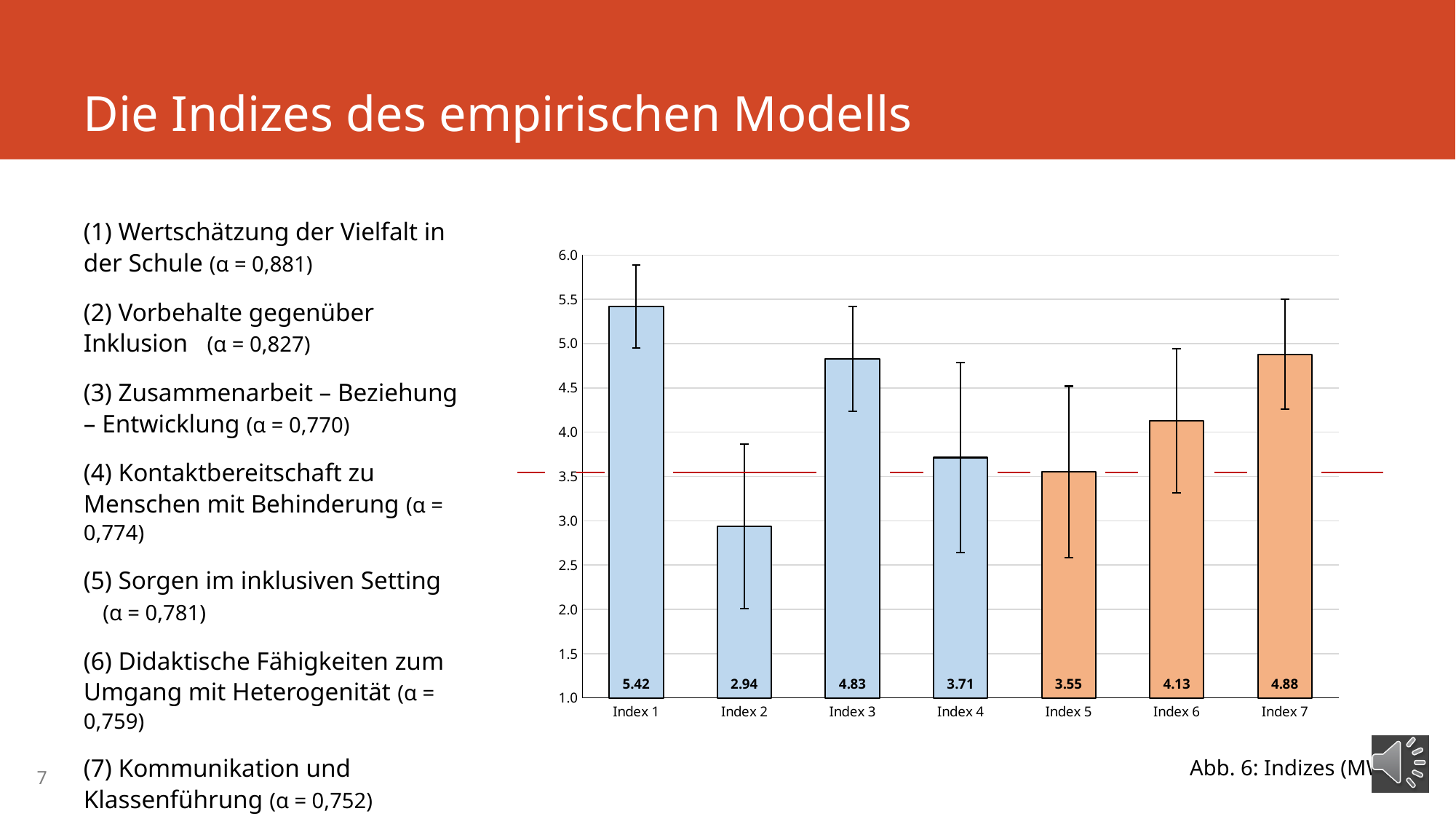
What kind of chart is shown? bar chart How many indices are shown on the x axis? 7 What is the difference between the values for Index 7 and Index 6? 0.75 Which index has the highest value? Index 1 How many bars are coloured orange? 3 What is the value for Index 5? 3.55 What is the value for Index 1? 5.42 Which is larger, the value for Index 3 or the value for Index 4? Index 3 What is the value for Index 7? 4.88 Is the value for Index 2 greater or less than 3.0? less What is the difference between the values for Index 1 and Index 2? 2.48 Which index has the lowest value? Index 2